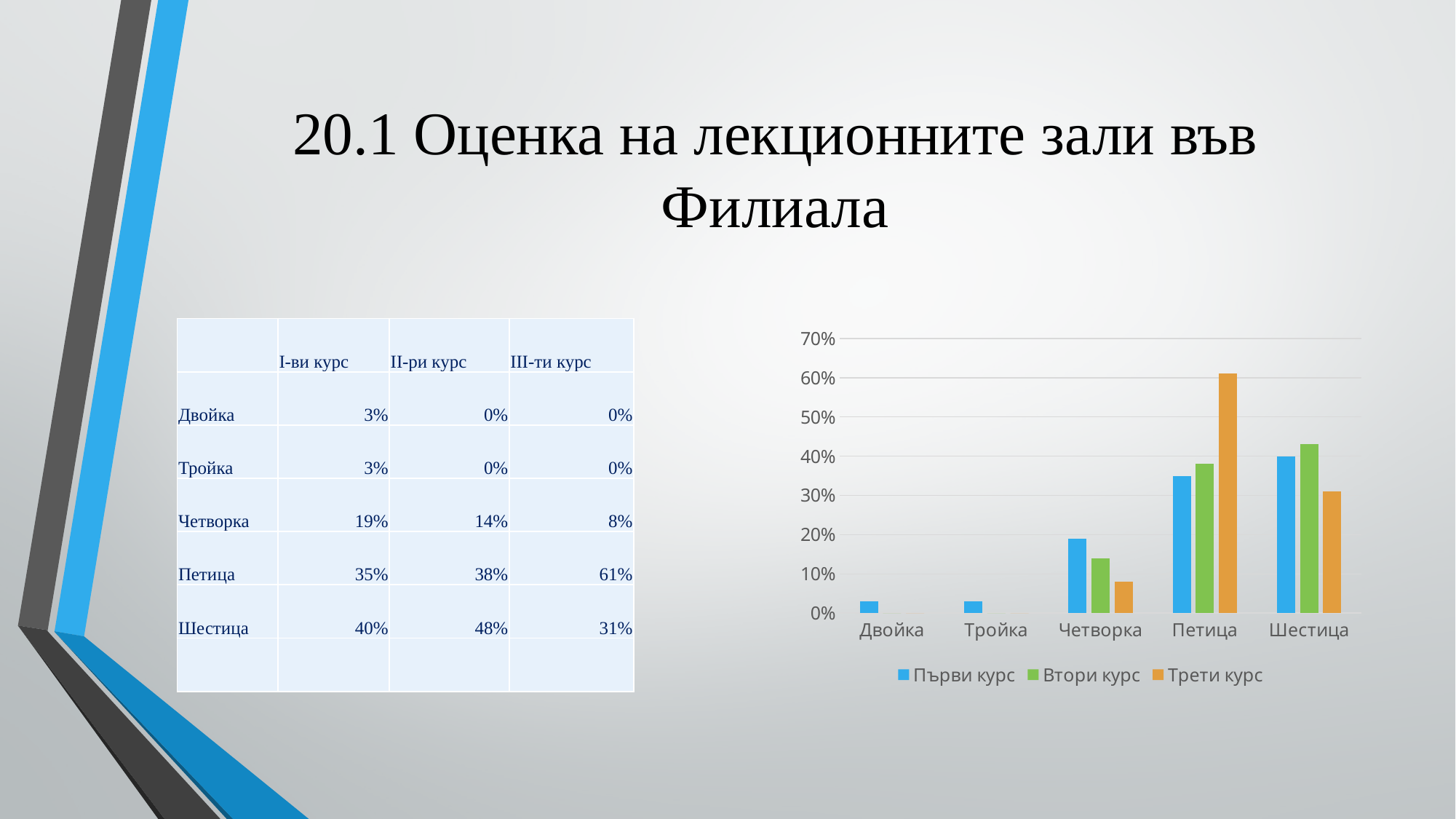
For Четворка, which is larger: Втори курс or Трети курс? Втори курс What kind of chart is shown on the slide? bar chart According to the table, what is the difference between Шестица for II-ри курс and I-ви курс? 8% How many categories are shown on the x axis of the chart? 5 Which legend entry is shown in orange? Трети курс Is the value for Трети курс at Петица greater or less than 50%? greater For Шестица, which is larger: Първи курс or Трети курс? Първи курс How many series does the chart legend list? 3 Is the value for Първи курс at Четворка greater or less than 20%? less According to the table, what is the value for Петица in III-ти курс? 61% Which category has the highest value for Трети курс? Петица Which category has the highest value for Втори курс? Шестица